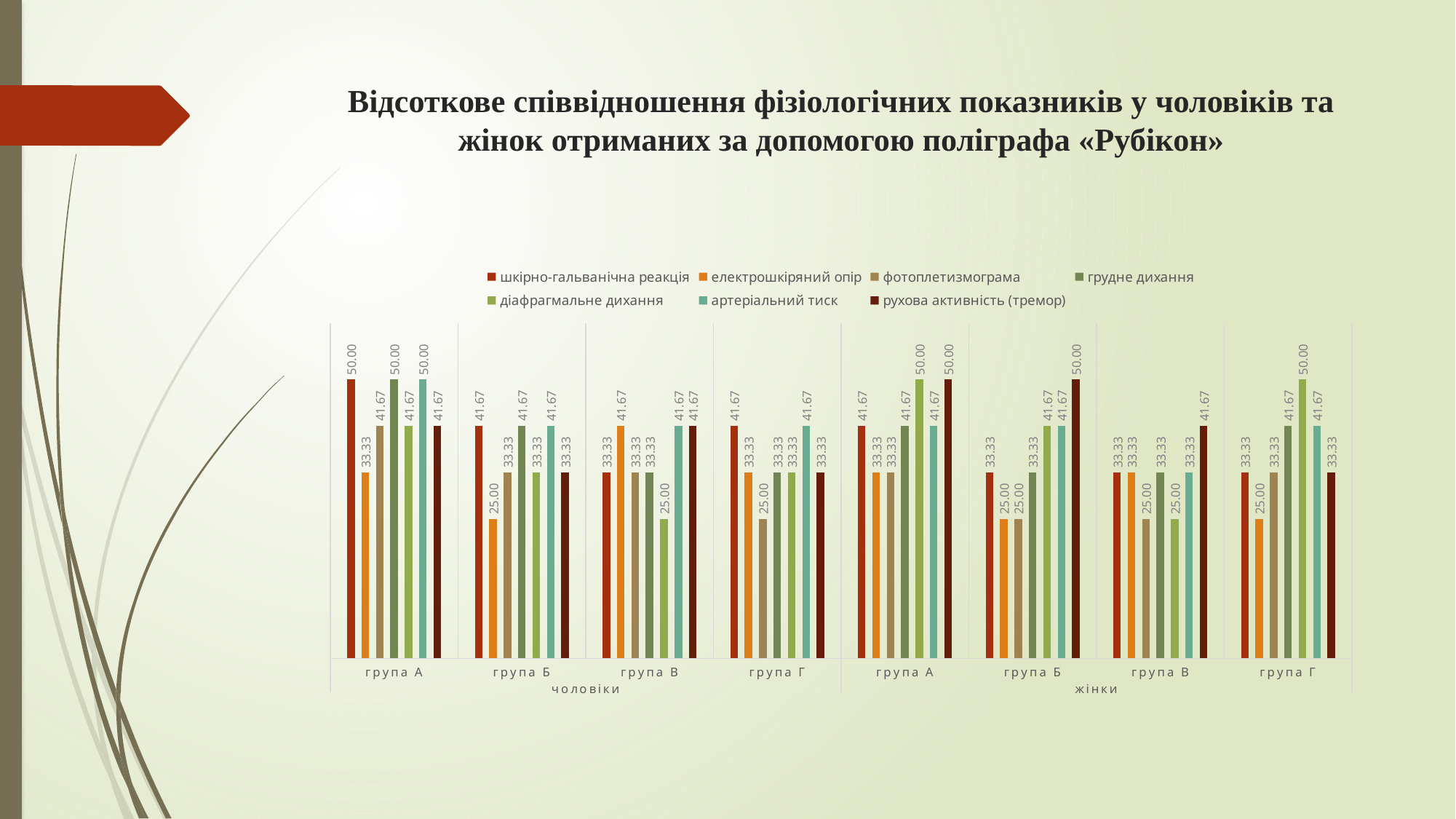
What is the value of рухова активність (тремор) for група Б among жінки? 50.00 What is the value of шкірно-гальванічна реакція for група А among чоловіки? 50.00 Which series is shown in orange in the legend? електрошкіряний опір What is the difference between шкірно-гальванічна реакція and електрошкіряний опір for група А among чоловіки? 16.67 How many group categories are shown along the x axis in total? 8 How many series does the legend list? 7 What is the value of електрошкіряний опір for група Б among чоловіки? 25.00 What is the value of діафрагмальне дихання for група Г among жінки? 50.00 Which series has the lowest value for група В among чоловіки? діафрагмальне дихання What kind of chart is shown on the slide? bar chart Which series has the highest value for група Б among жінки? рухова активність (тремор) Which is larger for група В among жінки: рухова активність (тремор) or фотоплетизмограма? рухова активність (тремор)